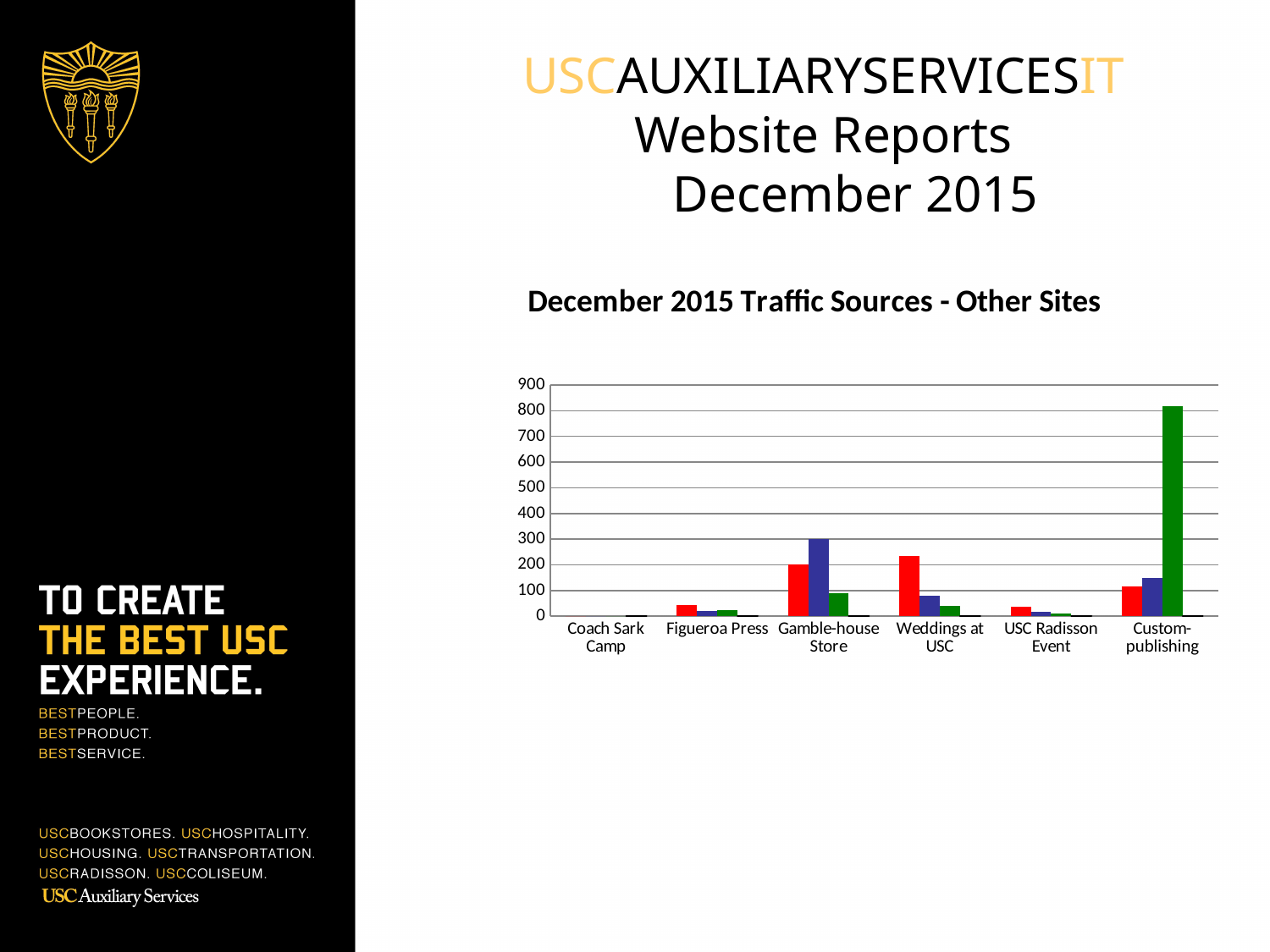
Is the value of the green bar for Custom-publishing greater or less than 700? greater Is the value of the red bar for Weddings at USC greater or less than 100? greater What type of chart is shown on the slide? bar chart Is the value of the red bar for USC Radisson Event greater or less than 100? less How many bars are plotted for each category in the chart? 3 Which category has the lowest bars in the chart? Coach Sark Camp Which is larger: the green bar for Custom-publishing or the blue bar for Gamble-house Store? the green bar for Custom-publishing How many categories are shown on the x axis of the chart? 6 What is the title of the chart? December 2015 Traffic Sources - Other Sites Which category has the tallest bar in the chart? Custom-publishing